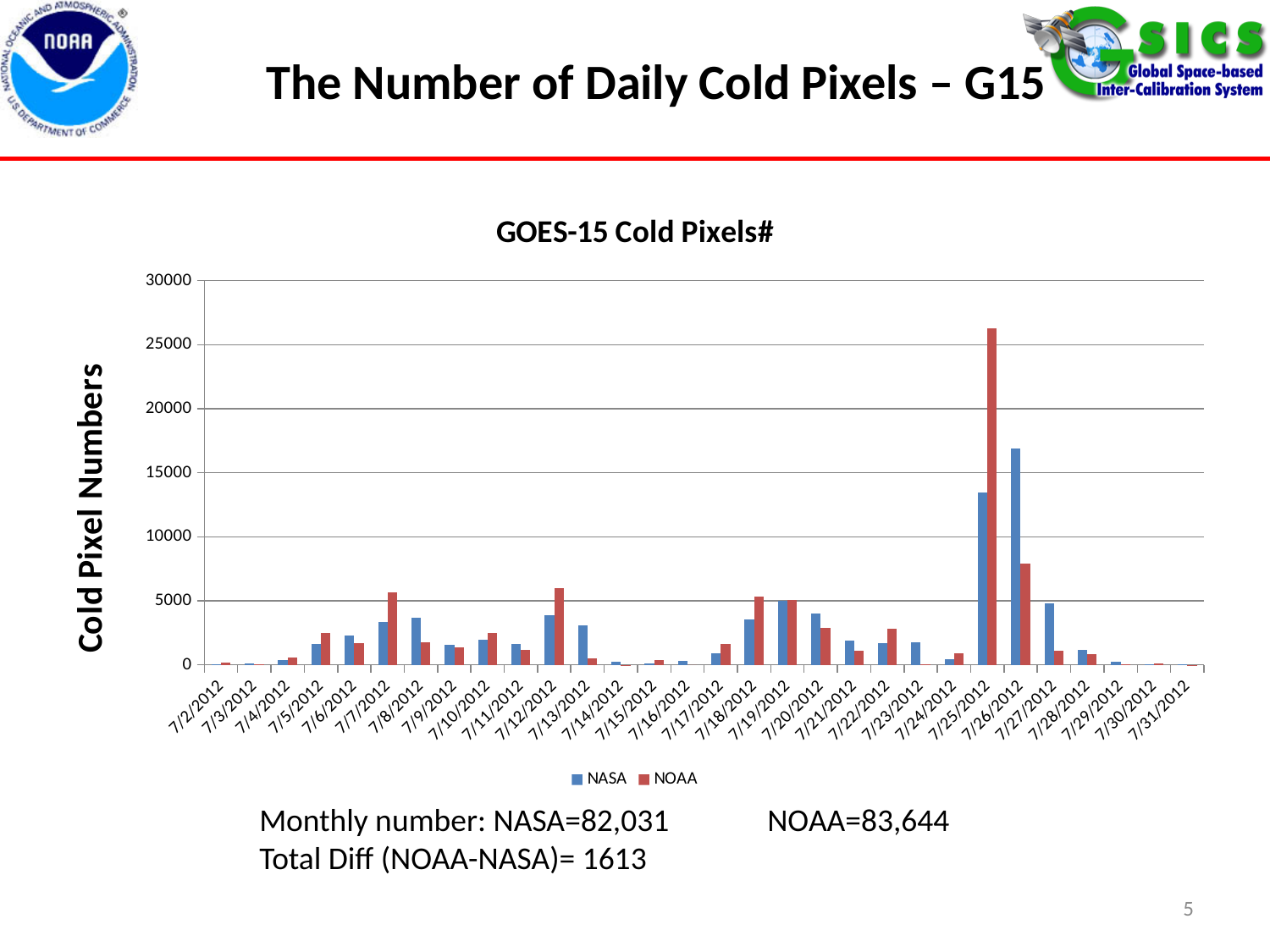
On which date is the NOAA value highest? 7/25/2012 On 7/26/2012, which series has the larger value, NASA or NOAA? NASA What is the title of the chart? GOES-15 Cold Pixels# On which date is the NASA value highest? 7/26/2012 Is the NASA value for 7/26/2012 greater or less than 15000? greater What kind of chart is shown on the slide? bar chart How many series does the legend list? 2 Is the NOAA value for 7/26/2012 greater or less than 10000? less On 7/8/2012, which series has the larger value, NASA or NOAA? NASA Is the NOAA value for 7/25/2012 greater or less than 25000? greater How many dates are shown along the x axis? 30